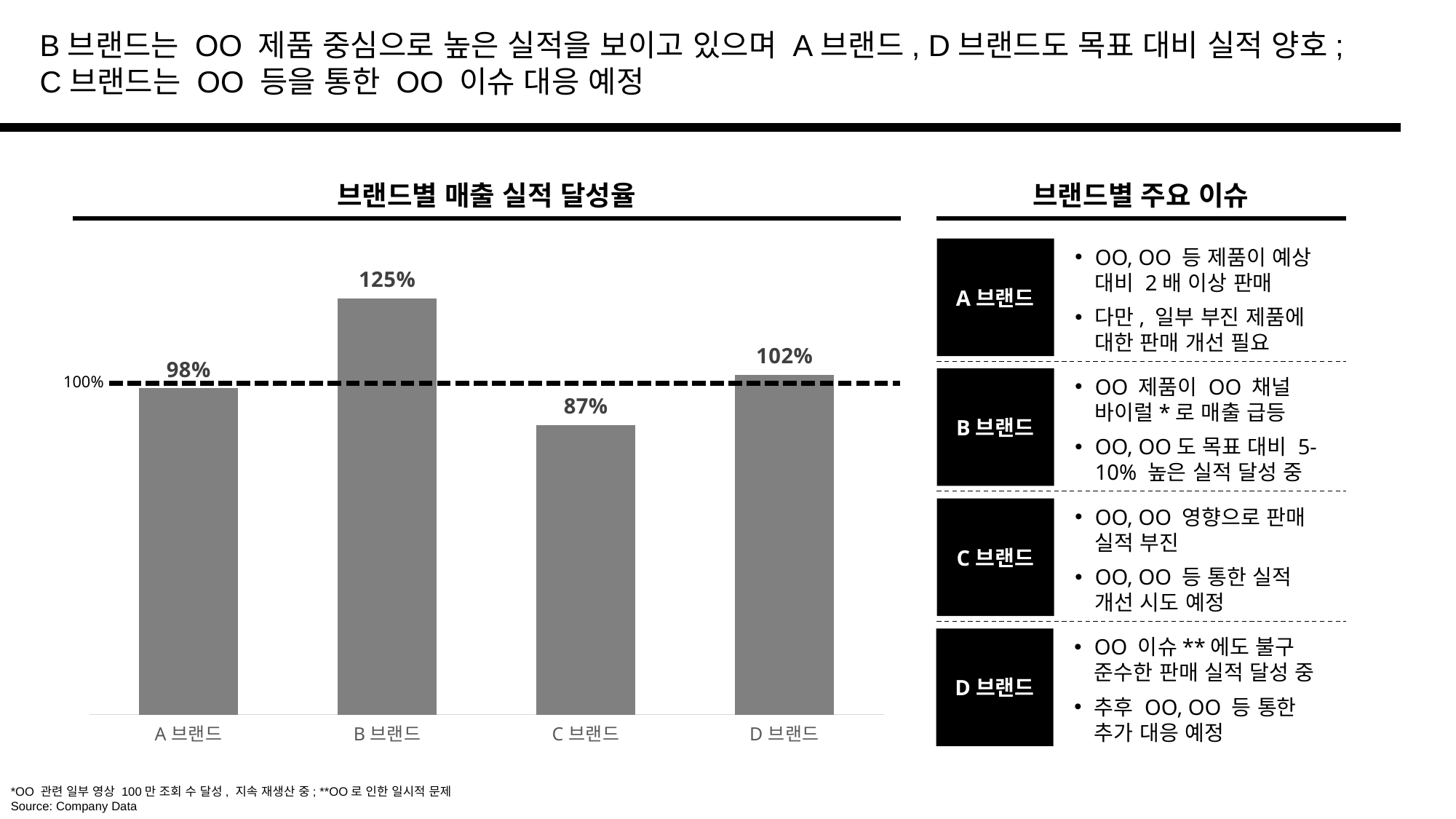
How many brands are shown in the 브랜드별 매출 실적 달성율 chart? 4 What is the difference between the values for D 브랜드 and A 브랜드 in the 브랜드별 매출 실적 달성율 chart? 4% Which is larger in the 브랜드별 매출 실적 달성율 chart, the value for A 브랜드 or D 브랜드? D 브랜드 What kind of chart is the 브랜드별 매출 실적 달성율 chart? Bar chart Which brand has the highest value in the 브랜드별 매출 실적 달성율 chart? B 브랜드 What is the value for B 브랜드 in the 브랜드별 매출 실적 달성율 chart? 125% What is the difference between the values for B 브랜드 and C 브랜드 in the 브랜드별 매출 실적 달성율 chart? 38% What is the value for C 브랜드 in the 브랜드별 매출 실적 달성율 chart? 87% Which brand has the lowest value in the 브랜드별 매출 실적 달성율 chart? C 브랜드 What value does the dashed horizontal reference line in the 브랜드별 매출 실적 달성율 chart mark? 100% What is the value for D 브랜드 in the 브랜드별 매출 실적 달성율 chart? 102% What is the value for A 브랜드 in the 브랜드별 매출 실적 달성율 chart? 98%